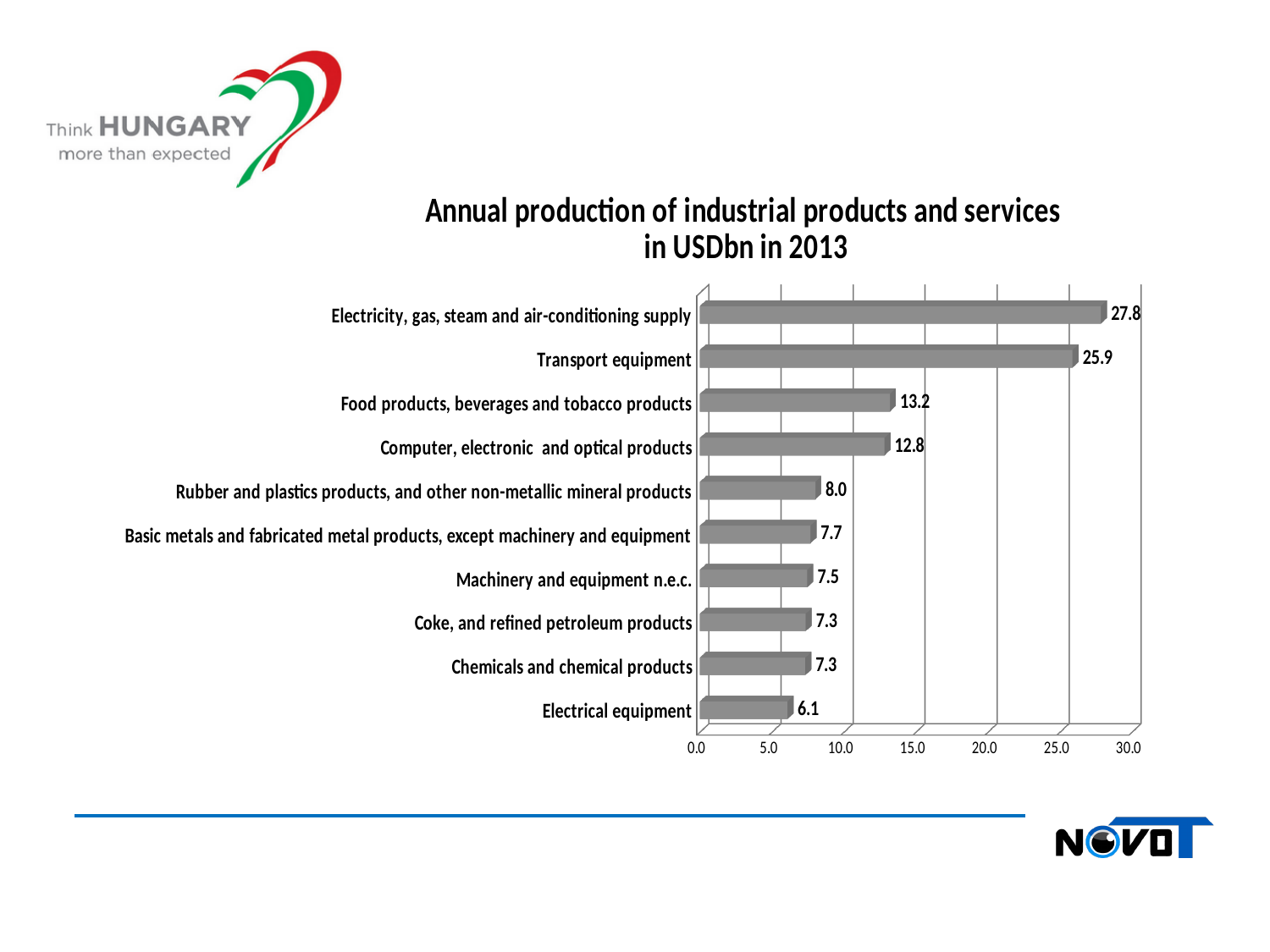
Which category has the lowest annual production value? Electrical equipment What kind of chart is shown on the slide? Bar chart What is the value shown for Computer, electronic and optical products? 12.8 How many categories are shown in the chart? 10 Which category has the highest annual production value? Electricity, gas, steam and air-conditioning supply What is the title of the chart? Annual production of industrial products and services in USDbn in 2013 Is the value for Food products, beverages and tobacco products greater or less than 10.0? greater Which is larger, the value for Rubber and plastics products, and other non-metallic mineral products or the value for Machinery and equipment n.e.c.? Rubber and plastics products, and other non-metallic mineral products What is the annual production value for Transport equipment? 25.9 What is the value shown for Electrical equipment? 6.1 What is the difference between the values for Food products, beverages and tobacco products and Electrical equipment? 7.1 What is the difference between the values for Electricity, gas, steam and air-conditioning supply and Transport equipment? 1.9